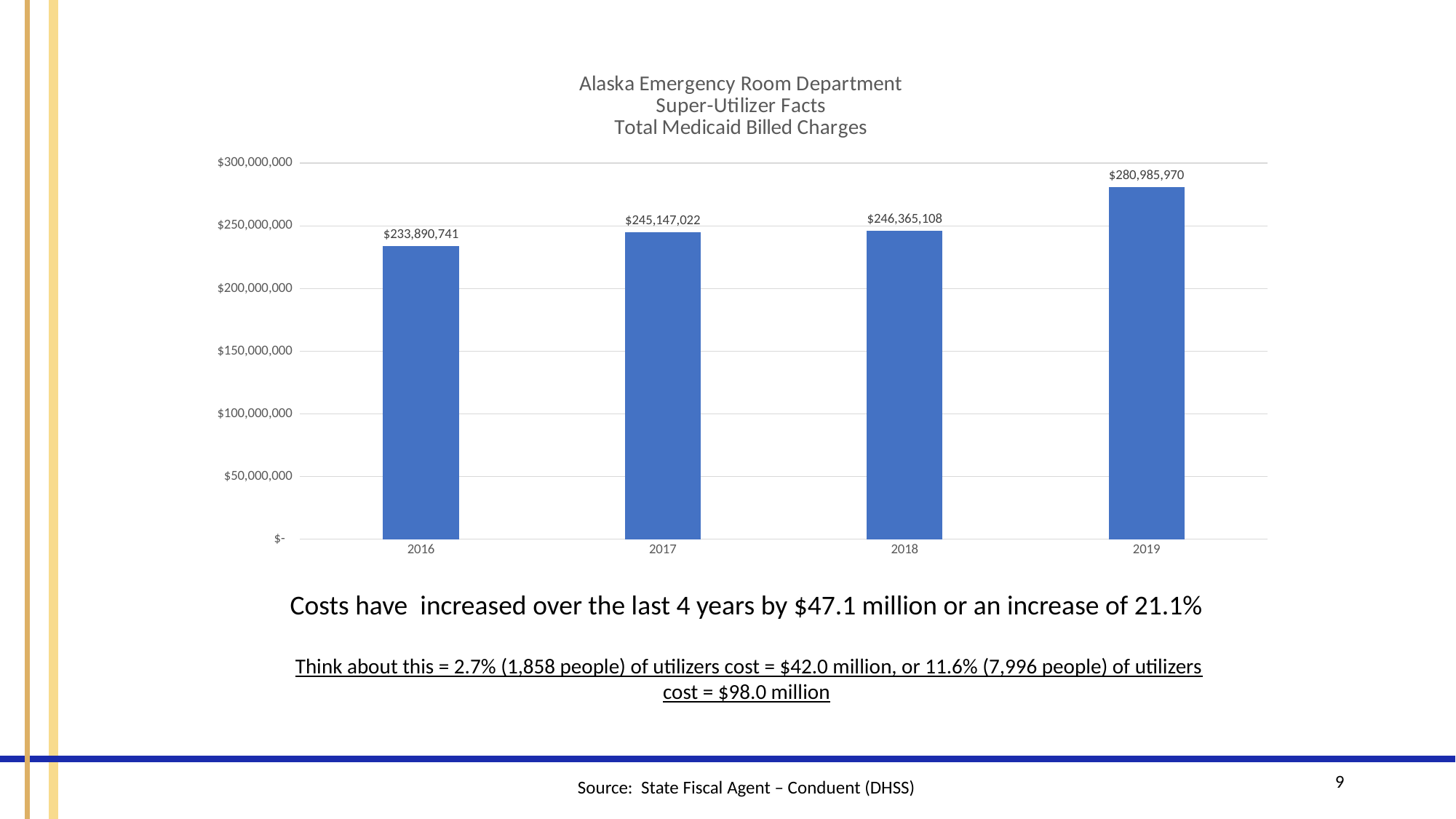
Is the value for 2016 greater or less than $250,000,000? less Which year has the lowest total Medicaid billed charges? 2016 Which year has the highest total Medicaid billed charges? 2019 Do the values rise or fall from 2016 to 2019? rise What kind of chart is this? bar chart What is the difference between the values for 2018 and 2017? $1,218,086 Which is larger, the value for 2017 or the value for 2018? 2018 What is the value for 2019? $280,985,970 What is the difference between the values for 2019 and 2016? $47,095,229 What is the value for 2016? $233,890,741 What is the value for 2017? $245,147,022 How many years are shown on the x axis? 4